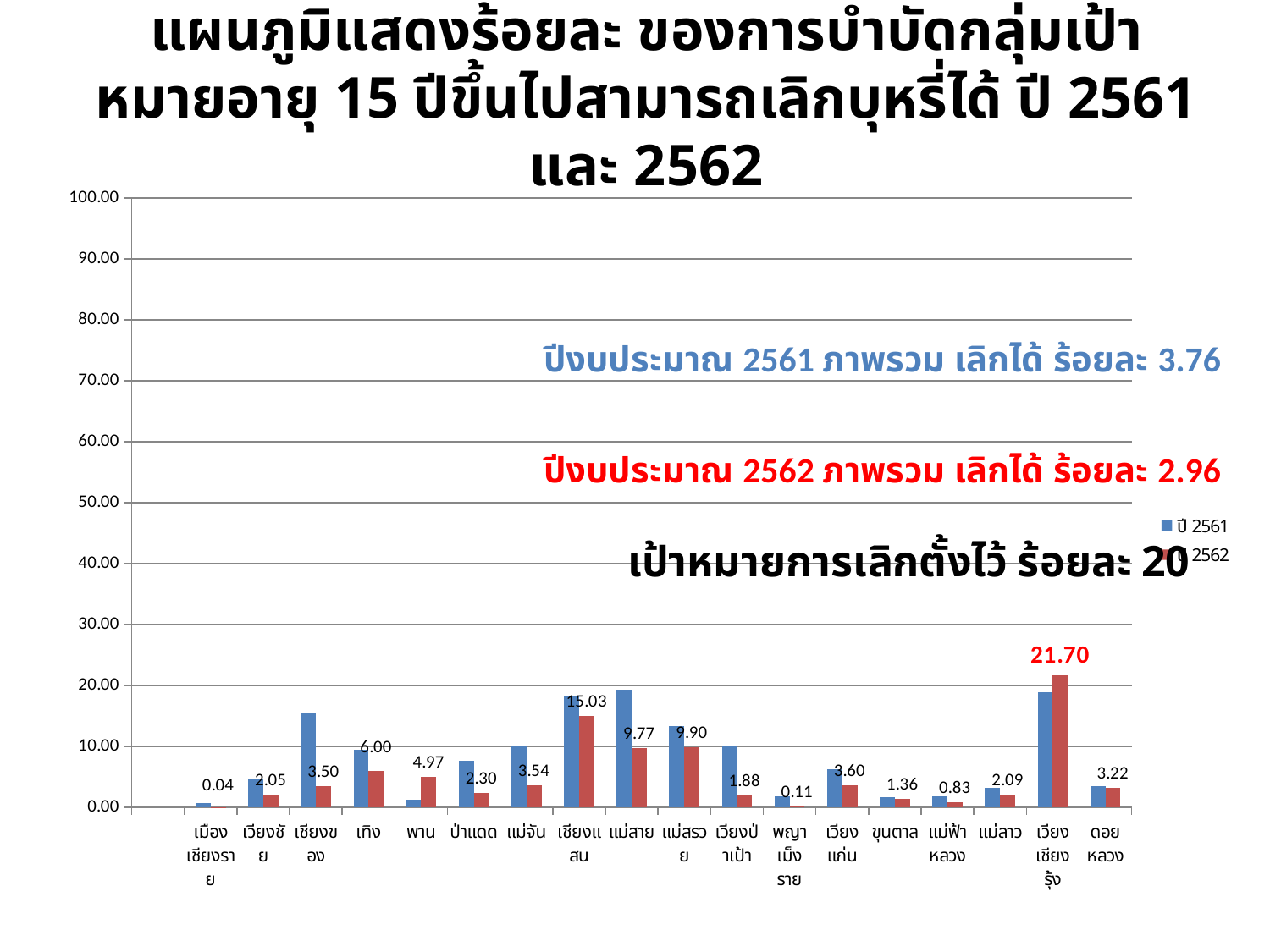
For ปี 2562, which is larger: เทิง or พาน? เทิง Which category has the lowest value for ปี 2562? เมืองเชียงราย What kind of chart is shown on the slide? bar chart What is the value for ปี 2562 in เวียงเชียงรุ้ง? 21.70 What is the difference between the ปี 2562 values for เวียงเชียงรุ้ง and เชียงแสน? 6.67 Which category has the highest value for ปี 2562? เวียงเชียงรุ้ง What is the value for ปี 2562 in พญาเม็งราย? 0.11 What is the value for ปี 2562 in เชียงแสน? 15.03 How many series does the legend list? 2 Is the value for ปี 2561 in เมืองเชียงราย greater or less than 10.00? less How many categories are shown on the x axis? 18 Is the value for ปี 2561 in เชียงของ greater or less than 10.00? greater